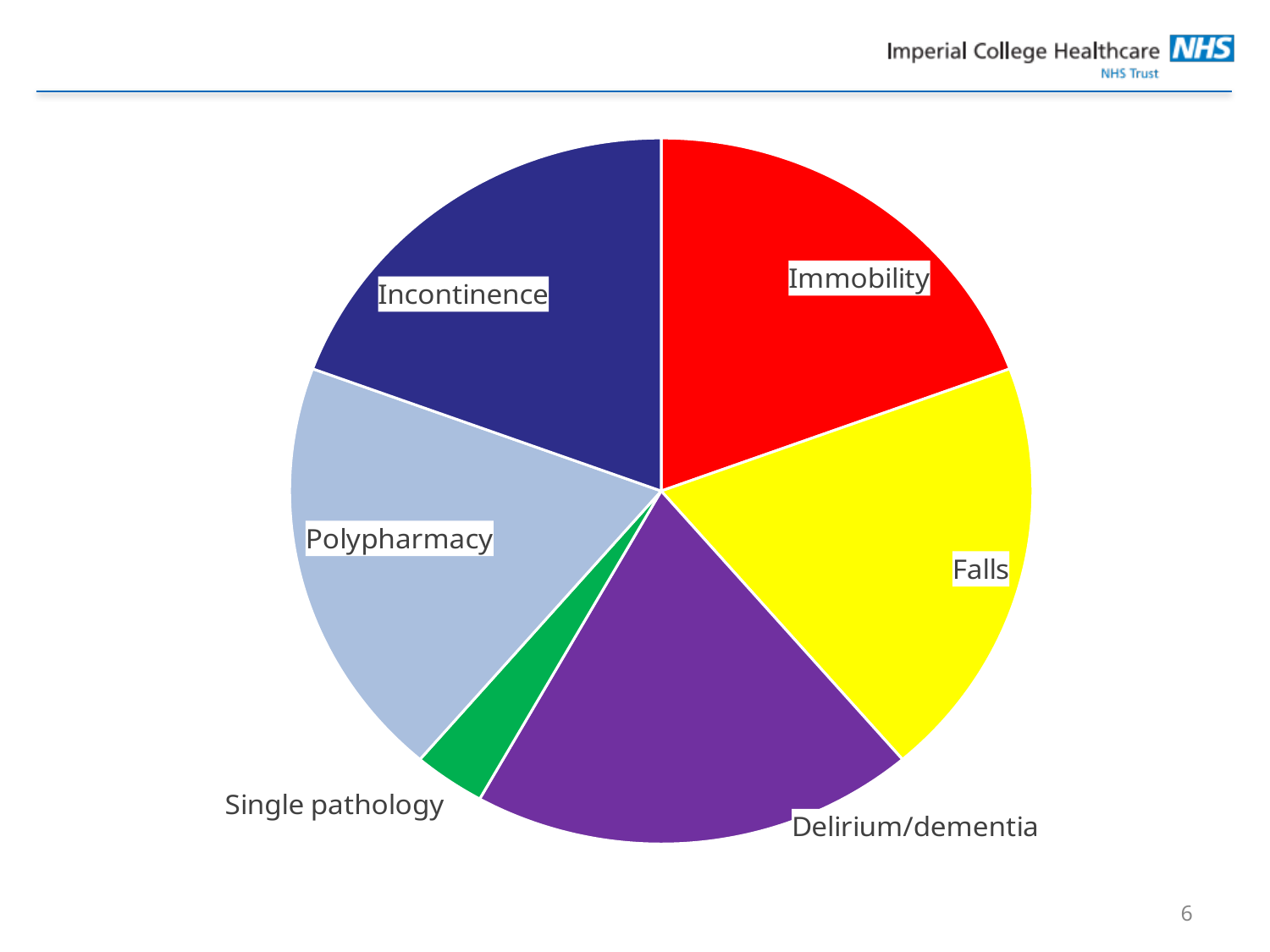
Which slice is larger, Falls or Single pathology? Falls Which slice is larger, Single pathology or Polypharmacy? Polypharmacy Which category has the smallest slice of the pie chart? Single pathology How many slices does the pie chart have? 6 What colour is the Immobility slice of the pie chart? red Which slice is larger, Single pathology or Delirium/dementia? Delirium/dementia Which category is shown by the green slice of the pie chart? Single pathology What kind of chart is shown on the slide? pie chart